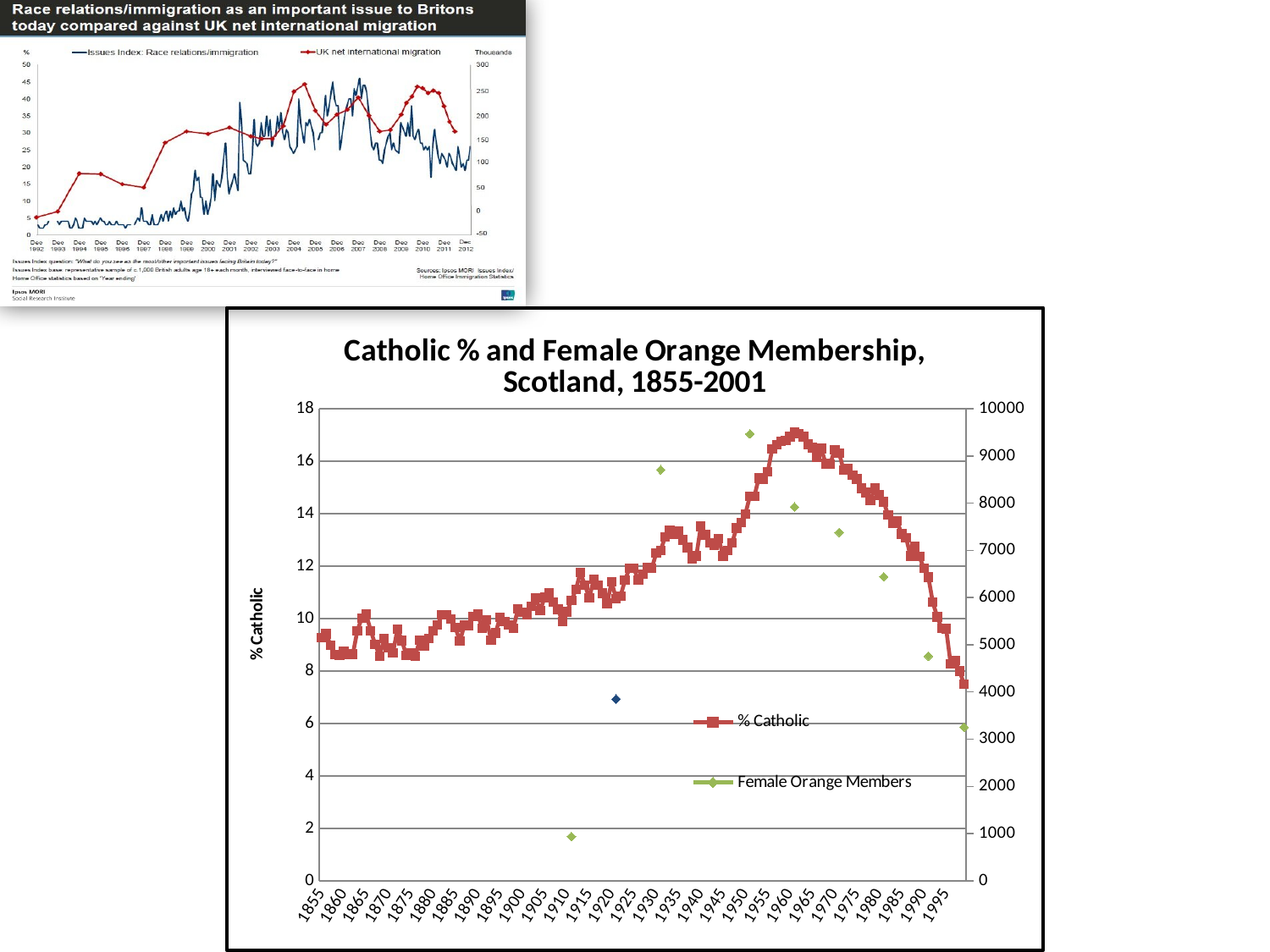
On the chart titled 'Catholic % and Female Orange Membership, Scotland, 1855-2001', does the % Catholic series rise or fall between 1965 and 2001? fall On the chart titled 'Catholic % and Female Orange Membership, Scotland, 1855-2001', what is the highest value shown on the right vertical axis? 10000 On the chart titled 'Catholic % and Female Orange Membership, Scotland, 1855-2001', does the % Catholic series generally rise or fall between 1900 and 1960? rise On the small chart at the top left of the slide, how many series does the legend list? 2 On the chart titled 'Catholic % and Female Orange Membership, Scotland, 1855-2001', is the % Catholic value in 1855 greater or less than 10? less On the chart titled 'Catholic % and Female Orange Membership, Scotland, 1855-2001', what is the label of the left vertical axis? % Catholic On the chart titled 'Catholic % and Female Orange Membership, Scotland, 1855-2001', is the Female Orange Members value around 1950 greater or less than 9000? greater On the chart titled 'Catholic % and Female Orange Membership, Scotland, 1855-2001', is the earliest Female Orange Members point (around 1912) greater or less than 1000? less On the chart titled 'Catholic % and Female Orange Membership, Scotland, 1855-2001', what kind of chart is it? line chart On the chart titled 'Catholic % and Female Orange Membership, Scotland, 1855-2001', how many series does the legend list? 2